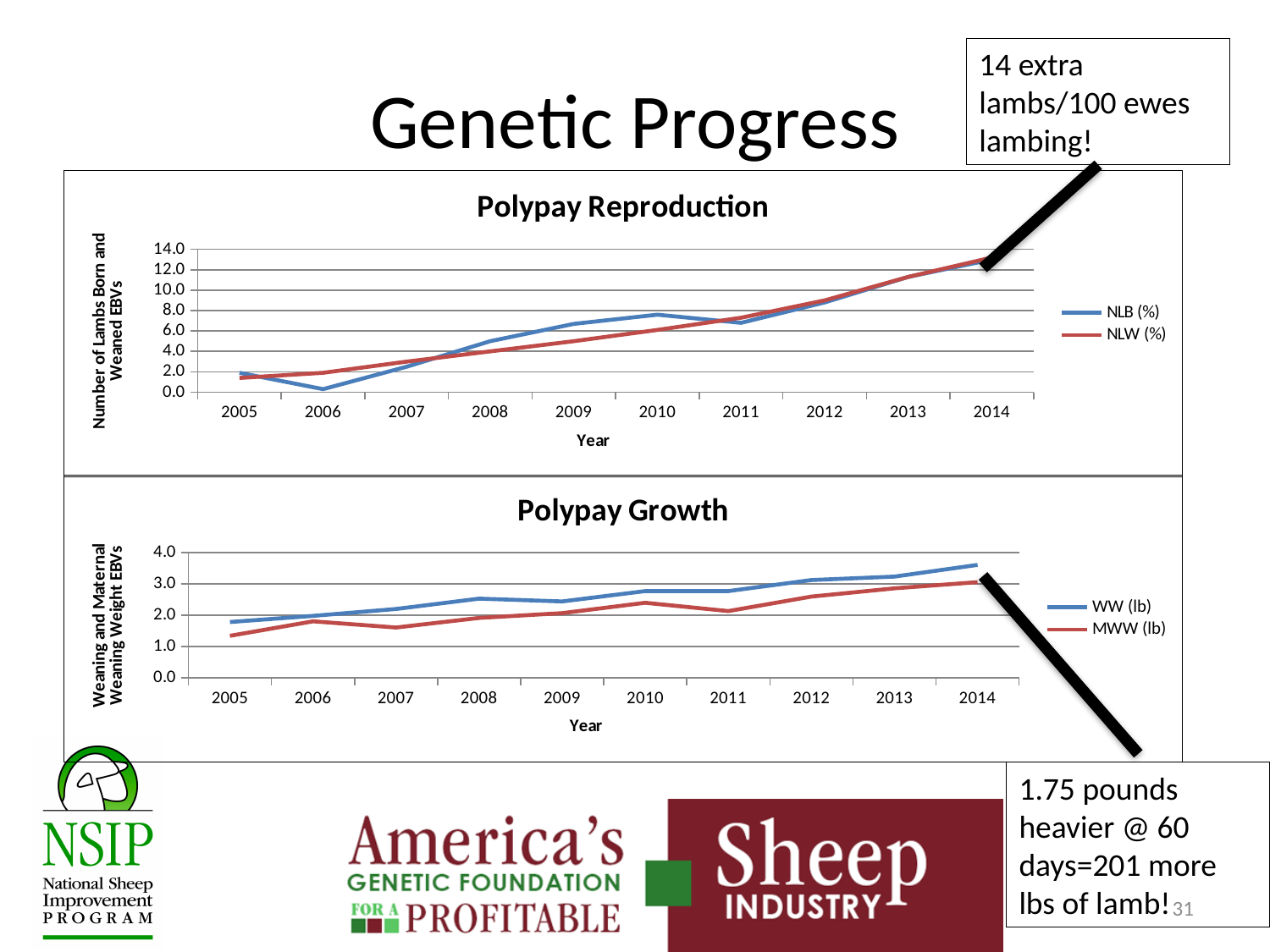
How many series does the legend of the Polypay Growth chart list? 2 In the Polypay Growth chart, is the WW (lb) value for 2014 greater or less than 3.0? greater In the Polypay Growth chart, which series has the larger value in 2010, WW (lb) or MWW (lb)? WW (lb) In the Polypay Reproduction chart, how many years are plotted along the x axis? 10 In the Polypay Reproduction chart, is the NLB (%) value for 2006 greater or less than 2.0? less What is the x-axis title of the Polypay Growth chart? Year In the Polypay Reproduction chart, do the NLW (%) values generally rise or fall from 2005 to 2014? rise What kind of chart is the Polypay Growth chart? line chart In the Polypay Reproduction chart, which series has the larger value in 2010, NLB (%) or NLW (%)? NLB (%) How many series does the legend of the Polypay Reproduction chart list? 2 What kind of chart is the Polypay Reproduction chart? line chart In the Polypay Reproduction chart, is the NLB (%) value for 2014 greater or less than 12.0? greater